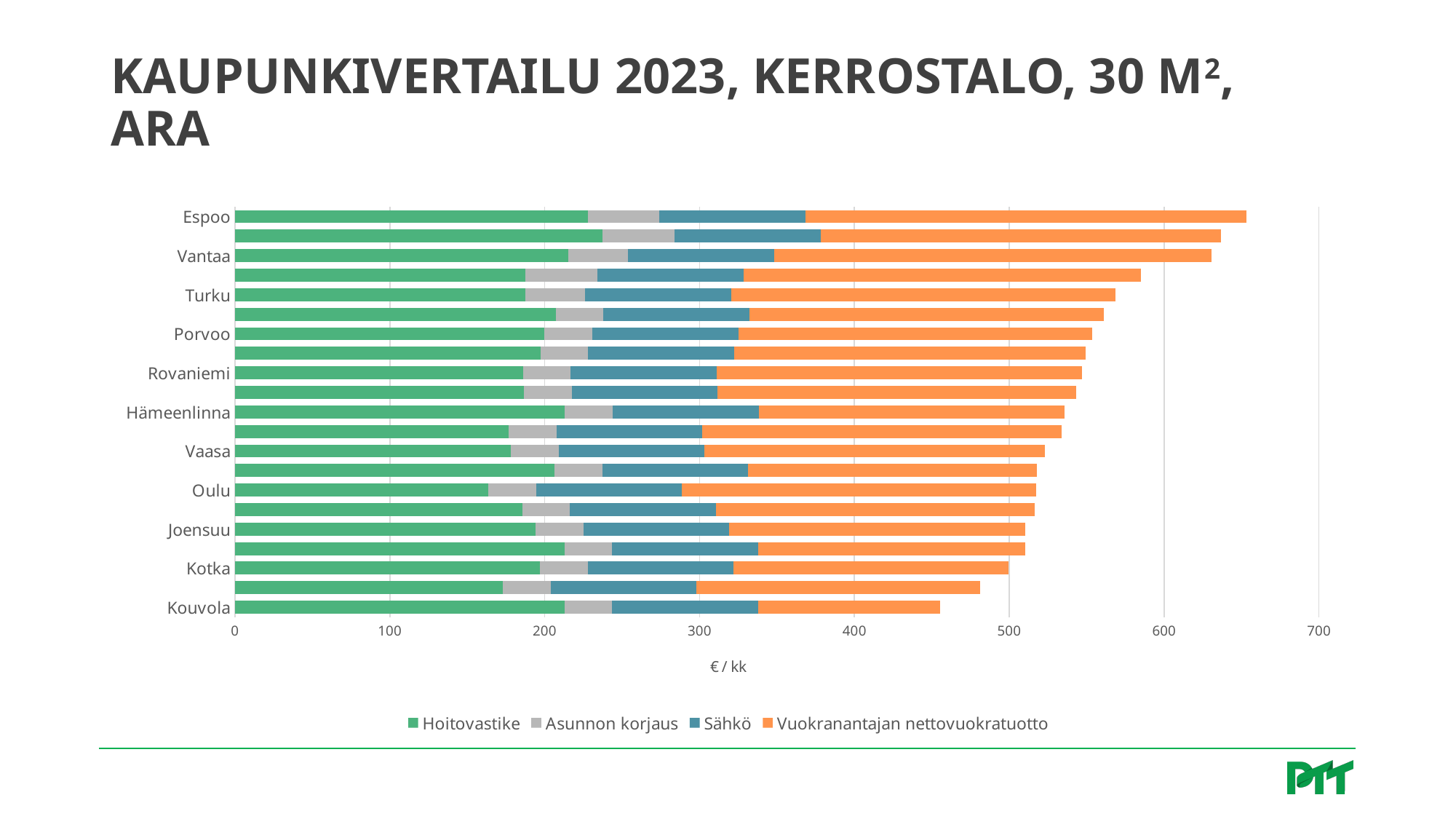
How many series does the legend list? 4 What is the label on the horizontal axis? € / kk Is the total value for Kouvola greater or less than 500? less Is the Hoitovastike value for Oulu greater or less than 200? less What kind of chart is shown on the slide? Stacked bar chart Is the total value for Espoo greater or less than 600? greater Which has the larger total bar, Vantaa or Turku? Vantaa Do the total bar lengths increase or decrease going from the top of the chart (Espoo) to the bottom (Kouvola)? decrease Which city has the lowest total bar? Kouvola Which city has the highest total bar? Espoo Which has the larger Hoitovastike value, Espoo or Oulu? Espoo